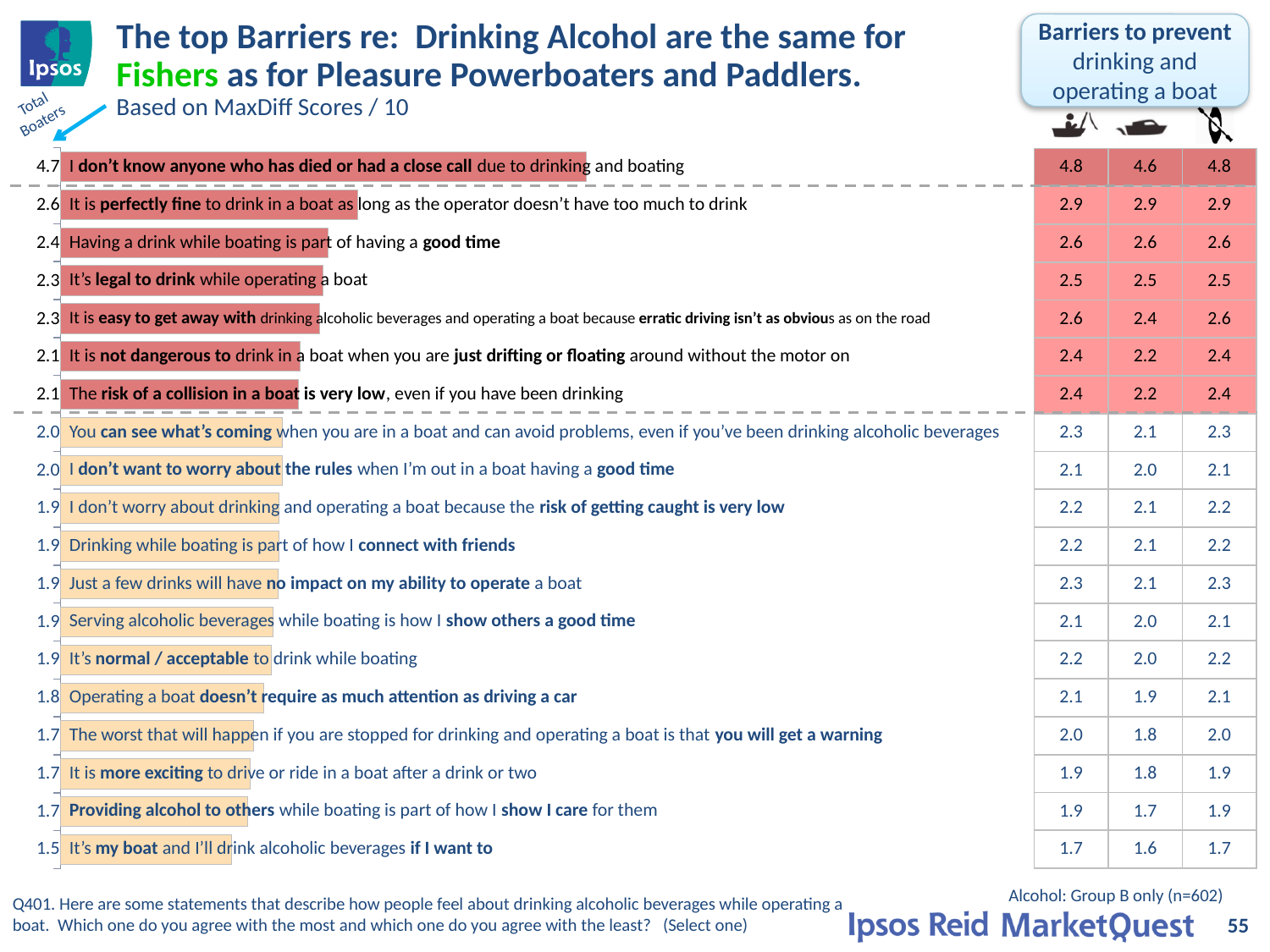
What is the Total Boaters MaxDiff score for "It's legal to drink while operating a boat"? 2.3 Do the Total Boaters scores increase or decrease going from the top bar to the bottom bar? Decrease According to the subtitle, what are the bar values based on? MaxDiff Scores / 10 Which statement has the highest Total Boaters MaxDiff score in the bar chart? I don't know anyone who has died or had a close call due to drinking and boating What is the Total Boaters MaxDiff score for "It's my boat and I'll drink alcoholic beverages if I want to"? 1.5 Which statement has the lowest Total Boaters MaxDiff score in the bar chart? It's my boat and I'll drink alcoholic beverages if I want to What is the difference between the Total Boaters scores for "I don't know anyone who has died or had a close call" (4.7) and "It is perfectly fine to drink in a boat as long as the operator doesn't have too much to drink" (2.6)? 2.1 What is the Total Boaters MaxDiff score for "Operating a boat doesn't require as much attention as driving a car"? 1.8 What kind of chart is used to show the Total Boaters MaxDiff scores? Bar chart How many statements (bars) are shown in the bar chart? 19 What is the Total Boaters MaxDiff score for "I don't know anyone who has died or had a close call due to drinking and boating"? 4.7 Which has a higher Total Boaters score: "It is perfectly fine to drink in a boat as long as the operator doesn't have too much to drink" or "Having a drink while boating is part of having a good time"? It is perfectly fine to drink in a boat as long as the operator doesn't have too much to drink